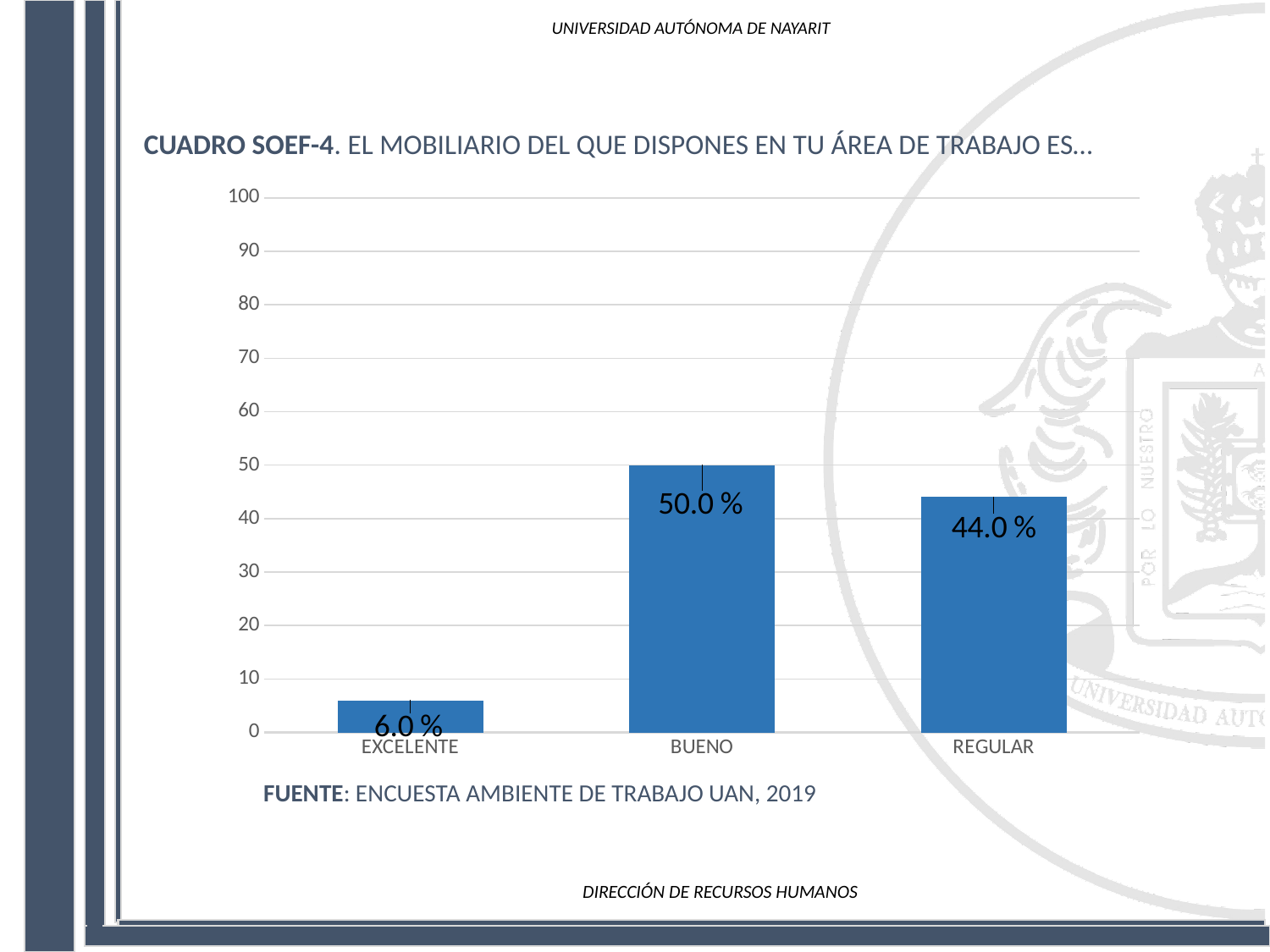
Which category has the highest value? BUENO Which category has the lowest value? EXCELENTE Is the value for REGULAR greater or less than 40? greater What is the difference between the values for BUENO and REGULAR? 6.0 % What is the difference between the values for REGULAR and EXCELENTE? 38.0 % What is the value for REGULAR? 44.0 % What is the value for BUENO? 50.0 % What kind of chart is shown on the slide? bar chart What source is cited below the chart? ENCUESTA AMBIENTE DE TRABAJO UAN, 2019 How many categories are shown on the x axis? 3 What is the value for EXCELENTE? 6.0 % Which is larger, the value for REGULAR or the value for EXCELENTE? REGULAR